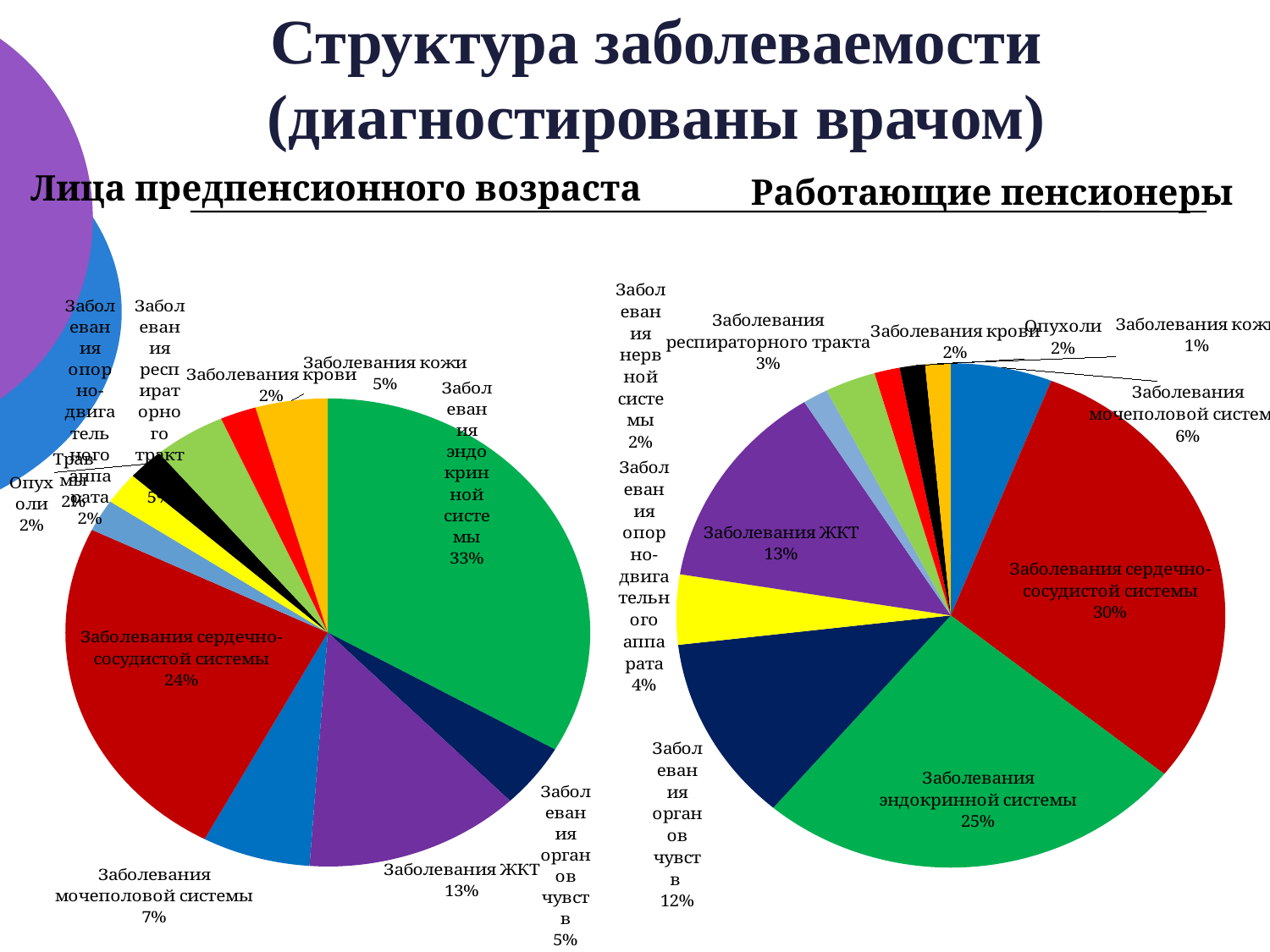
In the 'Лица предпенсионного возраста' pie chart, what share is Заболевания эндокринной системы? 33% In the 'Лица предпенсионного возраста' pie chart, what share is Заболевания мочеполовой системы? 7% In the 'Работающие пенсионеры' pie chart, what share is Заболевания сердечно-сосудистой системы? 30% What type of chart is used for 'Работающие пенсионеры'? Pie chart In the 'Работающие пенсионеры' pie chart, what share is Заболевания органов чувств? 12% In the 'Работающие пенсионеры' pie chart, what is the difference between Заболевания сердечно-сосудистой системы and Заболевания эндокринной системы? 5% How many slices does the 'Работающие пенсионеры' pie chart have? 11 In the 'Лица предпенсионного возраста' pie chart, which is larger: Заболевания сердечно-сосудистой системы or Заболевания ЖКТ? Заболевания сердечно-сосудистой системы In the 'Лица предпенсионного возраста' pie chart, which category has the largest share? Заболевания эндокринной системы What share is Заболевания ЖКТ in the 'Работающие пенсионеры' pie chart? 13% In the 'Работающие пенсионеры' pie chart, which category has the largest share? Заболевания сердечно-сосудистой системы